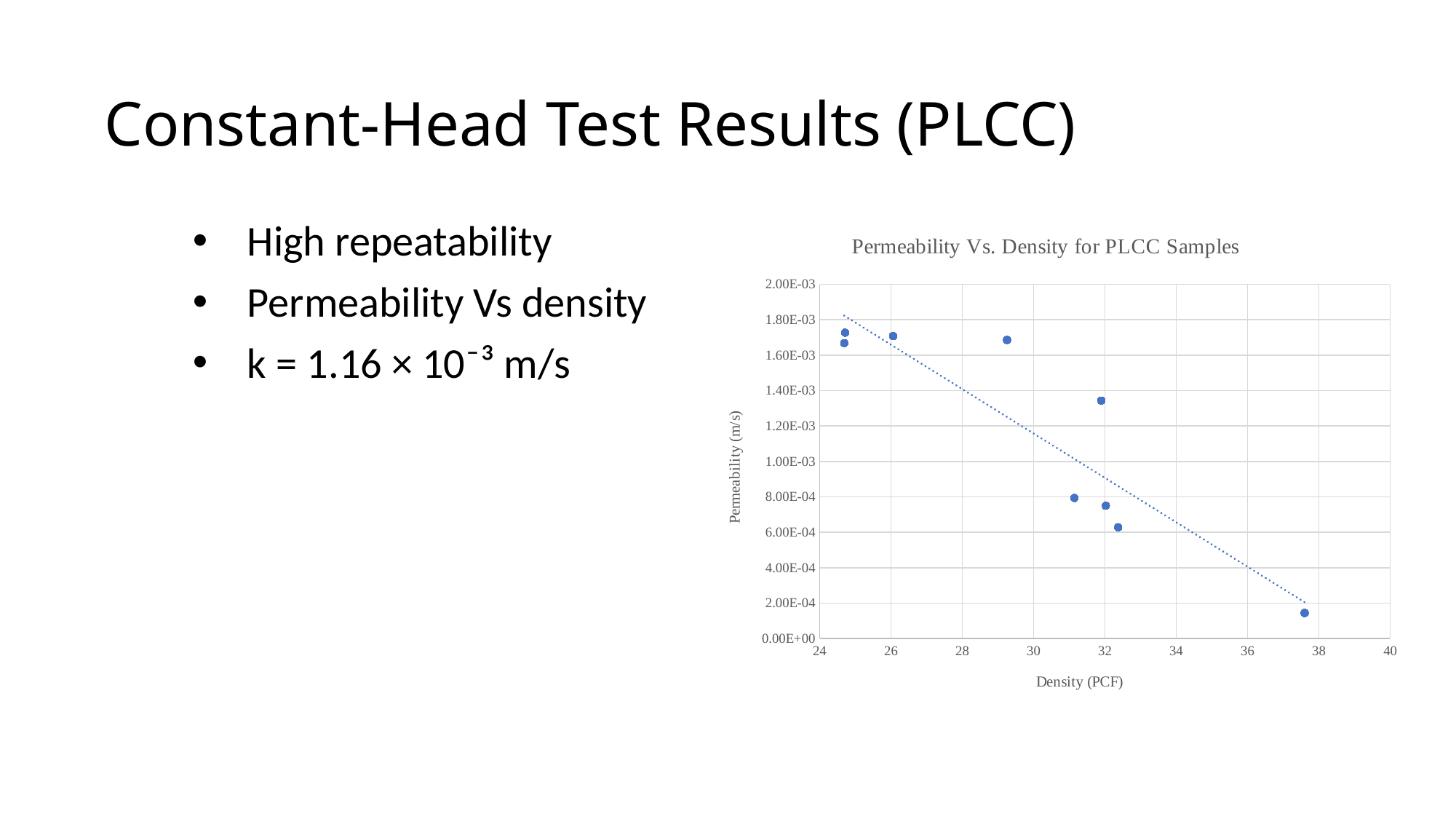
Is the permeability of the point with the highest density (near 38 PCF) greater or less than 2.00E-04 m/s? less As density increases along the x axis, does permeability generally rise or fall? Fall What is the maximum value shown on the y axis of the chart? 2.00E-03 What is the label of the x axis of the chart? Density (PCF) What is the title of the chart? Permeability Vs. Density for PLCC Samples How many data points are plotted in the chart? 9 Which has the higher permeability: the point at a density of about 26 PCF or the point at about 32.4 PCF? The point at about 26 PCF Is the permeability of the point at a density of about 31 PCF greater or less than 1.00E-03 m/s? less What kind of chart is shown on the slide? Scatter chart Is the permeability of the point at a density of about 32 PCF that lies above the trendline greater or less than 1.20E-03 m/s? greater Which point has the lowest permeability: the one at a density of about 38 PCF or the one at about 26 PCF? The one at about 38 PCF